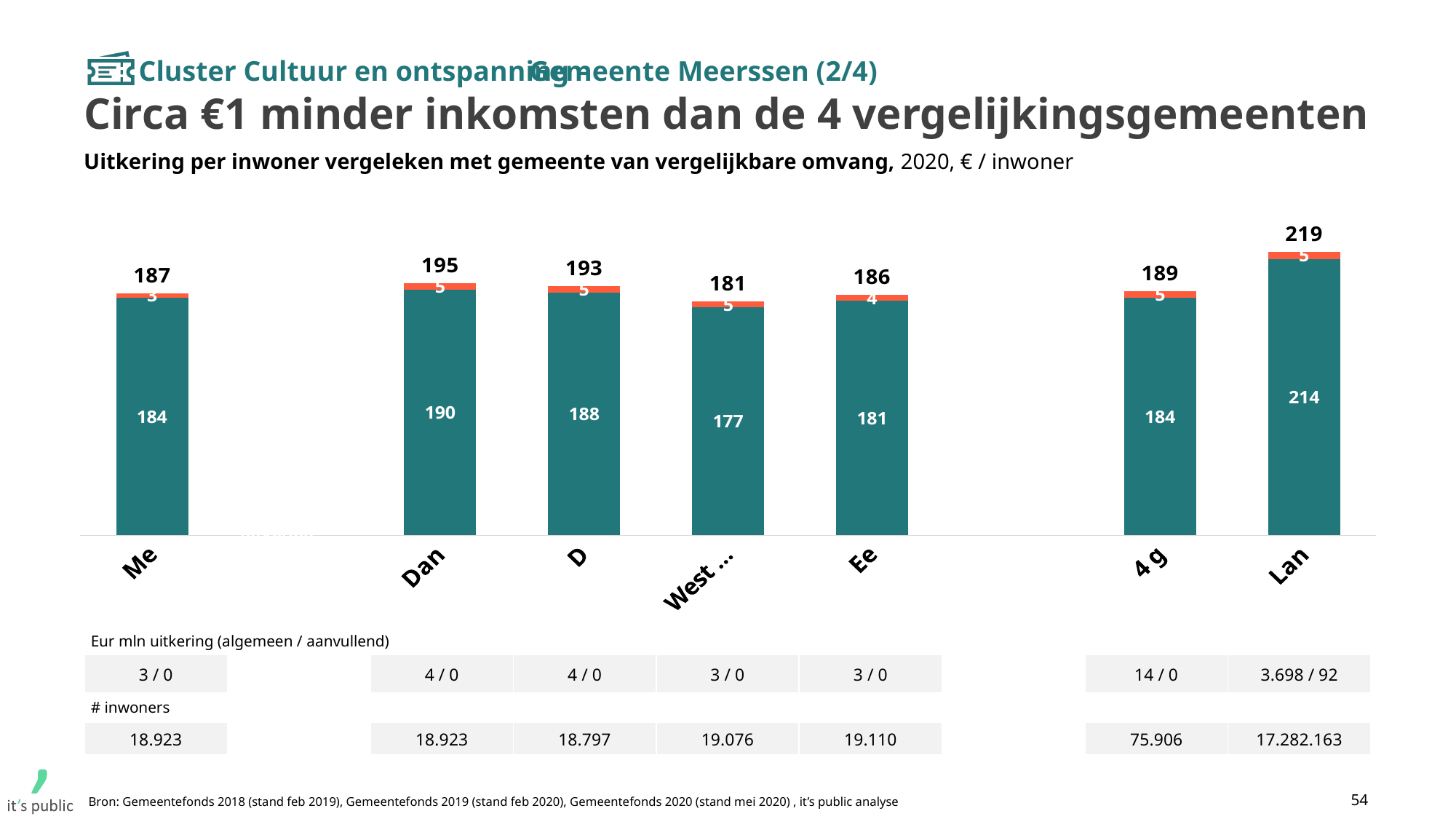
Which category has the lowest total value? West ... Which has a larger total value, "4 g" or "Ee"? 4 g What is the difference between the total for "Lan" and the total for "Me"? 32 What is the total value shown above the bar for "Me"? 187 How many bars are shown in the chart? 7 What is the value of the teal (lower) segment of the bar for "West ..."? 177 Which category has the highest total value? Lan What is the total value shown above the bar for "Lan"? 219 What is the value of the teal (lower) segment of the bar for "Dan"? 190 What is the value of the orange (upper) segment of the bar for "Ee"? 4 What kind of chart is shown on the slide? Stacked bar chart What is the difference between the total for "Dan" and the total for "D"? 2